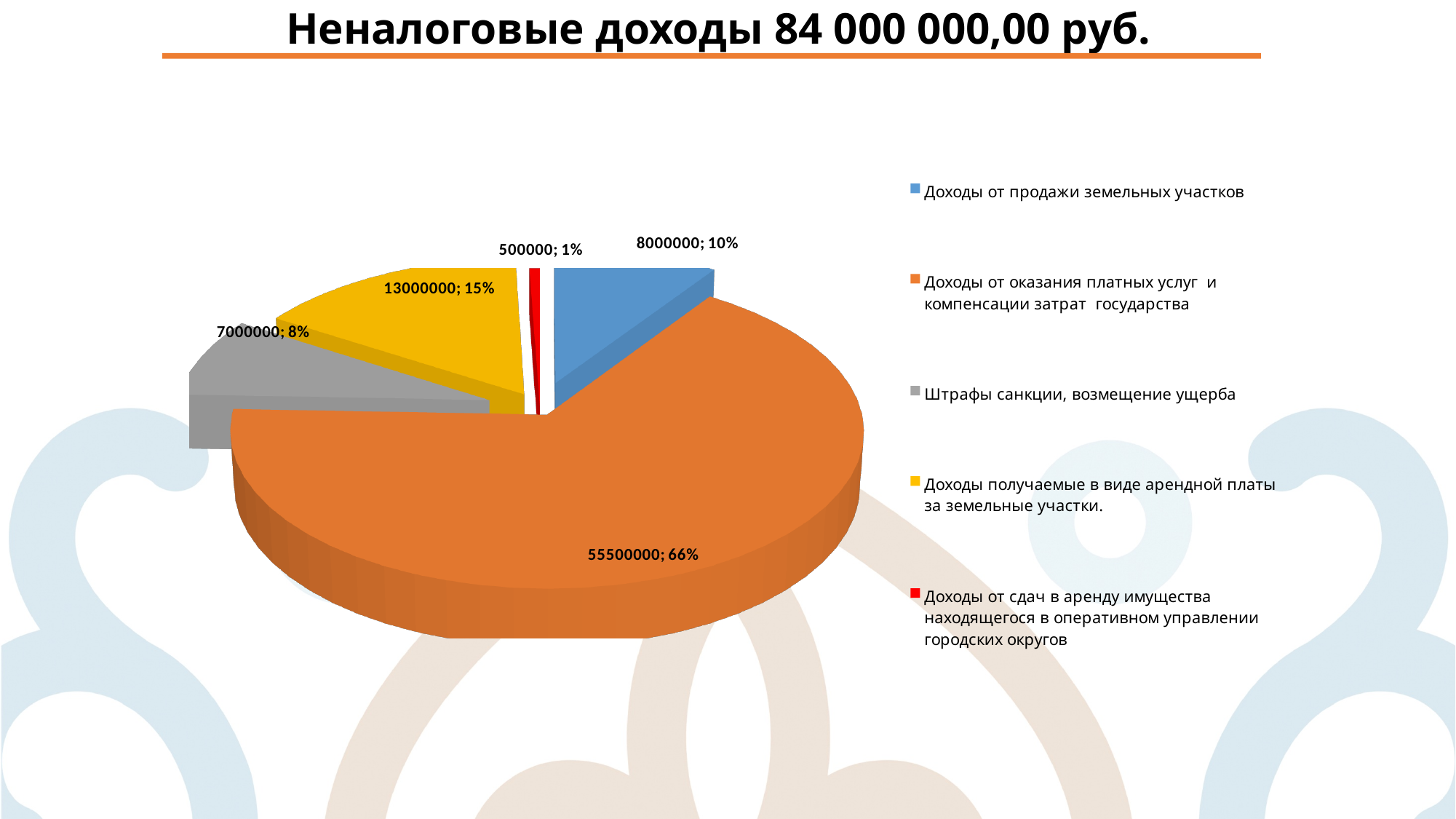
Какое значение указано для категории «Доходы от продажи земельных участков»? 8000000 Какое значение указано для категории «Доходы от оказания платных услуг и компенсации затрат государства»? 55500000 Какая категория имеет наибольшее значение? Доходы от оказания платных услуг и компенсации затрат государства Какое значение указано для категории «Доходы получаемые в виде арендной платы за земельные участки»? 13000000 Какое значение указано для категории «Штрафы санкции, возмещение ущерба»? 7000000 Какую долю круговой диаграммы занимает категория «Доходы получаемые в виде арендной платы за земельные участки»? 15% Сколько категорий показано на круговой диаграмме? 5 Что больше: значение категории «Доходы от продажи земельных участков» или «Штрафы санкции, возмещение ущерба»? Доходы от продажи земельных участков Какая категория имеет наименьшее значение? Доходы от сдач в аренду имущества находящегося в оперативном управлении городских округов Какой тип диаграммы показан на слайде? круговая диаграмма На сколько значение категории «Доходы получаемые в виде арендной платы за земельные участки» больше значения категории «Штрафы санкции, возмещение ущерба»? 6000000 Какую долю круговой диаграммы занимает категория «Доходы от сдач в аренду имущества находящегося в оперативном управлении городских округов»? 1%